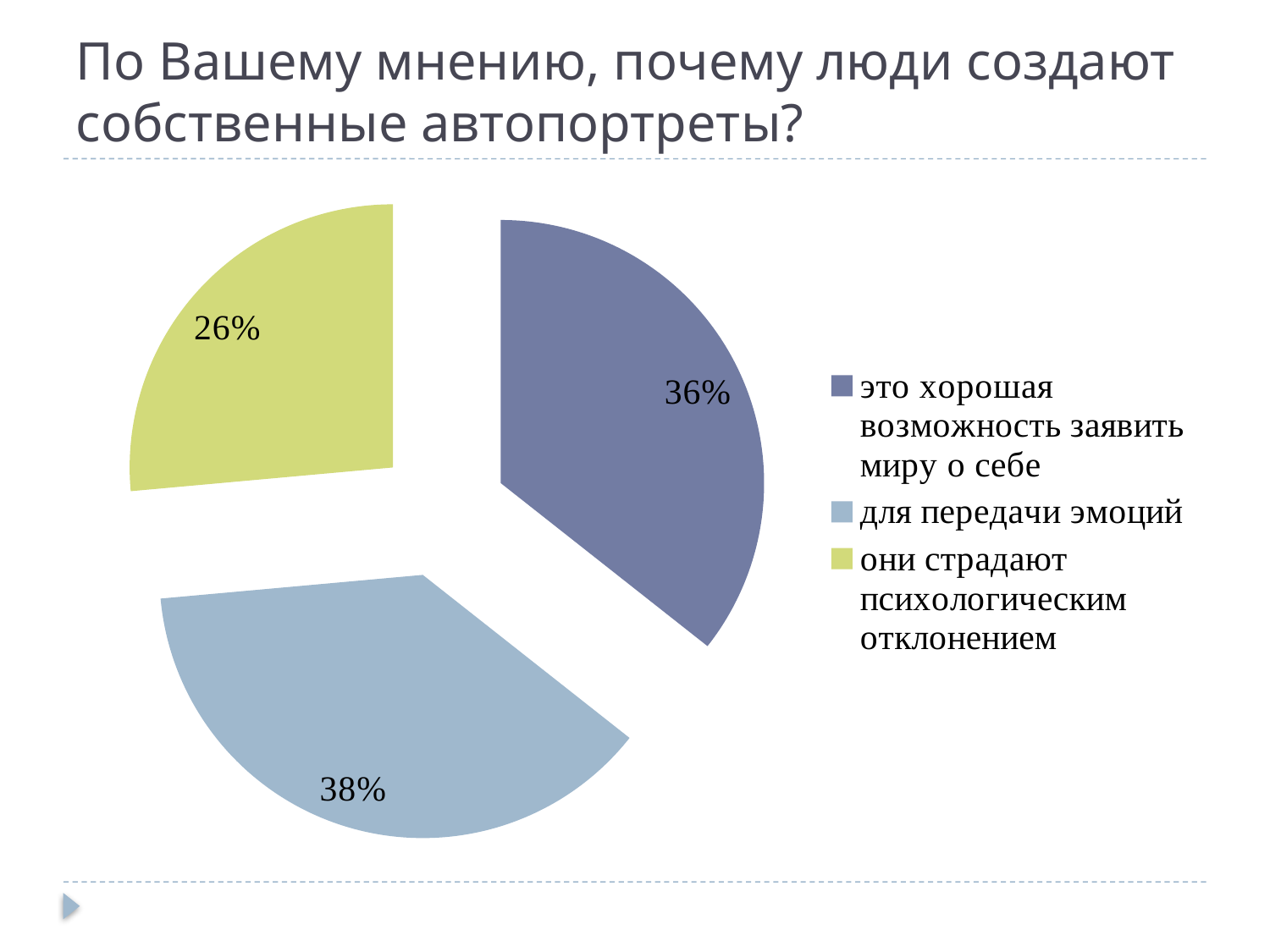
What is the title of the slide containing the chart? По Вашему мнению, почему люди создают собственные автопортреты? What is the difference in percentage points between "это хорошая возможность заявить миру о себе" and "они страдают психологическим отклонением"? 10 Which category has the largest slice of the pie? для передачи эмоций What is the difference in percentage points between "для передачи эмоций" and "они страдают психологическим отклонением"? 12 What share of the pie is labelled "для передачи эмоций"? 38% What colour is the slice for "они страдают психологическим отклонением"? yellow-green What kind of chart is shown on the slide? pie chart What share of the pie is labelled "это хорошая возможность заявить миру о себе"? 36% Which is larger: the slice for "это хорошая возможность заявить миру о себе" or the slice for "они страдают психологическим отклонением"? это хорошая возможность заявить миру о себе What share of the pie is labelled "они страдают психологическим отклонением"? 26% How many slices does the pie chart have? 3 Which category has the smallest slice of the pie? они страдают психологическим отклонением